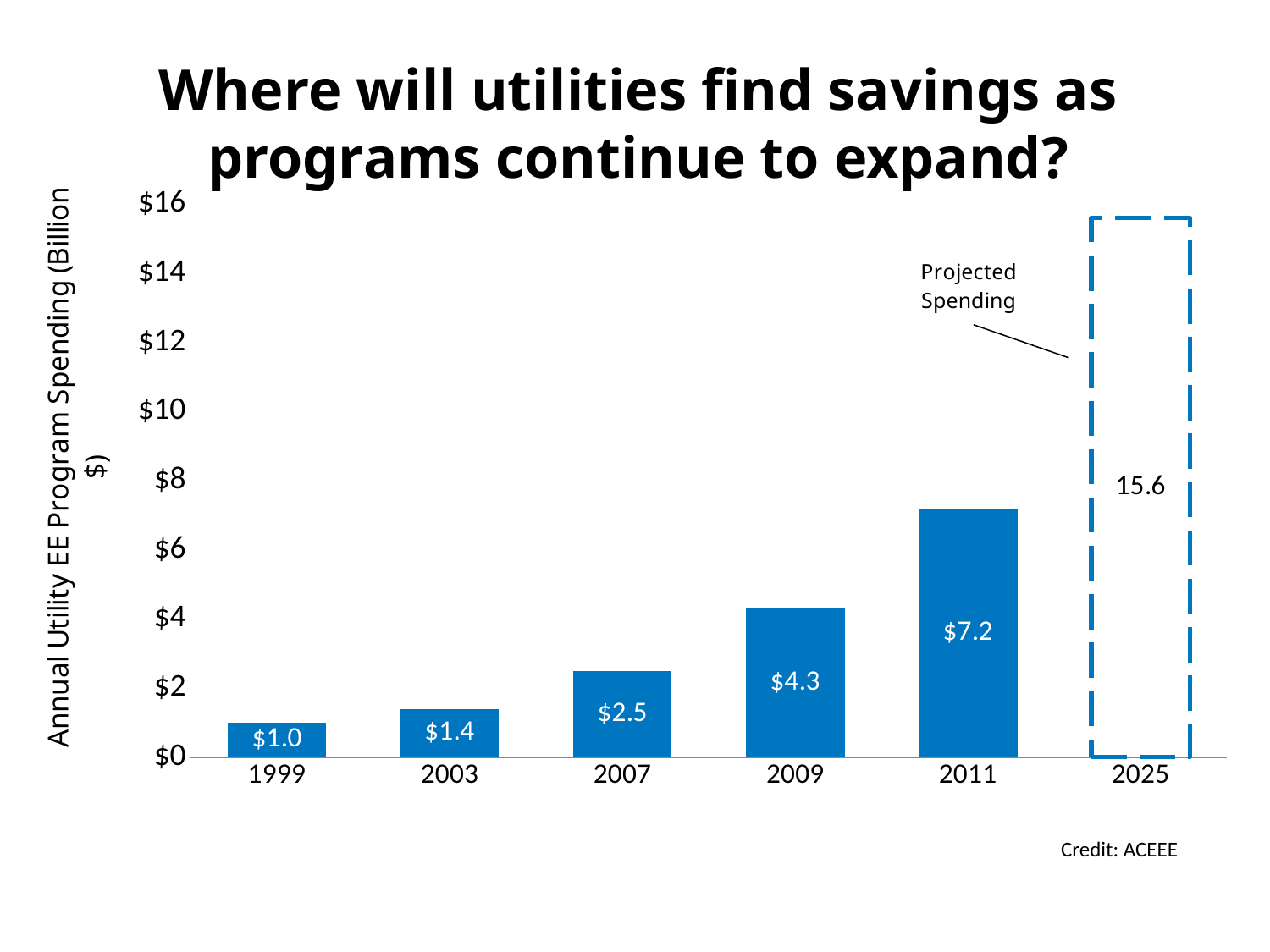
Is the value for 2011 greater or less than $6? greater Which year has the lowest spending value on the chart? 1999 Which is larger, the value for 2003 or the value for 2007? 2007 What is the difference between the 2011 value and the 2009 value? $2.9 How many years are shown on the x axis? 6 What is the label of the y axis? Annual Utility EE Program Spending (Billion $) What is the value labelled on the bar for 2007? $2.5 What is the annual utility EE program spending shown for 2011? $7.2 Do the values rise or fall from 1999 to 2025? rise What projected spending value is shown for 2025? 15.6 What kind of chart is shown on the slide? bar chart Which year has the highest value on the chart? 2025